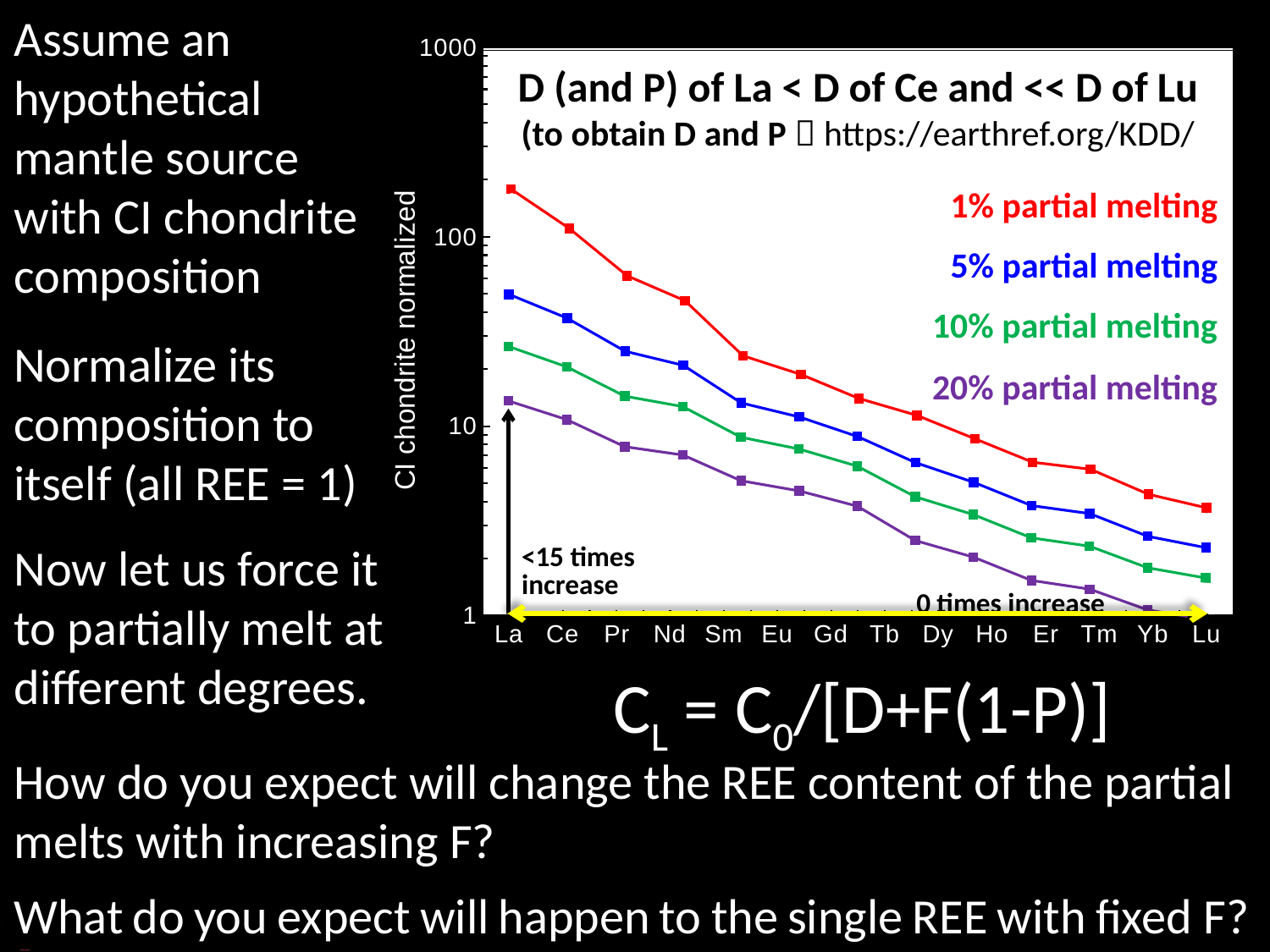
Do the CI chondrite normalized values rise or fall from La to Lu? fall For the 1% partial melting series, which element has the highest CI chondrite normalized value? La What is the label of the y axis? CI chondrite normalized Is the value for La in the 1% partial melting series greater or less than 100? greater Which series has the lowest values across the chart? 20% partial melting Is the value for La in the 20% partial melting series greater or less than 100? less At La, which is larger: the 1% partial melting value or the 20% partial melting value? 1% partial melting What kind of chart is shown on the slide? line chart Which series has the highest values across the chart? 1% partial melting Is the value for Lu in the 1% partial melting series greater or less than 10? less How many rare earth elements are plotted along the x axis? 14 How many partial melting series are shown on the chart? 4